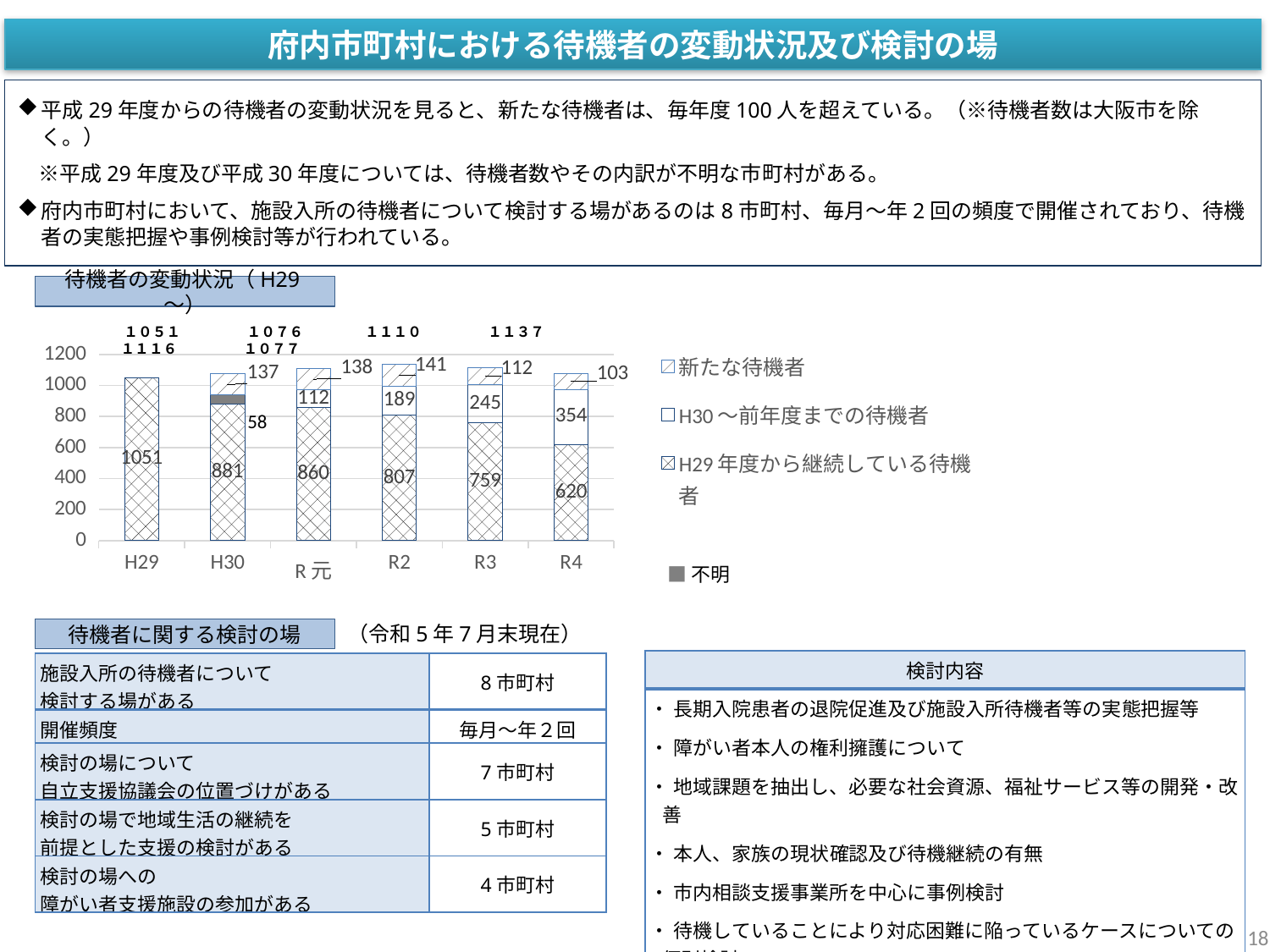
What kind of chart is shown under the heading 待機者の変動状況（H29～）? bar chart In the 待機者の変動状況 chart, which fiscal year has the lowest value for H29年度から継続している待機者? R4 In the 待機者の変動状況 chart, what is the value of 新たな待機者 for H30? 137 In the 待機者の変動状況 chart, what is the value of 不明 for H30? 58 How many series does the legend of the 待機者の変動状況 chart list? 4 In the 待機者の変動状況 chart, which is larger, the H30～前年度までの待機者 value for R3 or for R2? R3 In the 待機者の変動状況 chart, what is the difference between the 新たな待機者 values for R2 and R4? 38 In the 待機者の変動状況 chart, what is the value of H30～前年度までの待機者 for R3? 245 In the 待機者の変動状況 chart, does the H29年度から継続している待機者 series rise or fall from H29 to R4? fall In the 待機者の変動状況 chart, which fiscal year has the highest value for H29年度から継続している待機者? H29 In the 待機者の変動状況 chart, what is the value of H29年度から継続している待機者 for R4? 620 How many categories (fiscal years) are shown on the x axis of the 待機者の変動状況 chart? 6